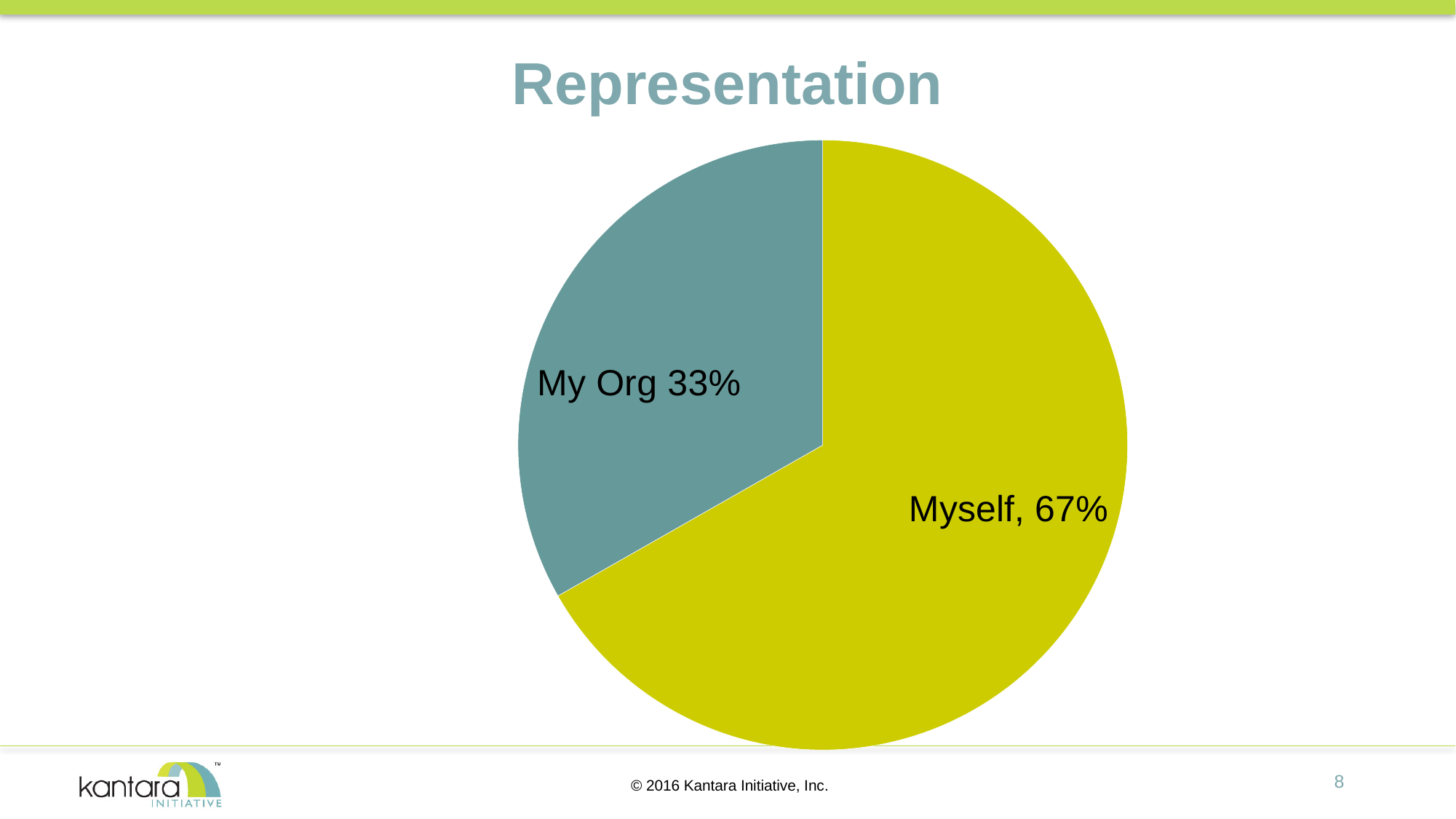
What is the title of the chart? Representation Which is larger, the Myself slice or the My Org slice? Myself What share of the pie does the My Org slice represent? 33% What share of the pie does the Myself slice represent? 67% Which slice is the largest? Myself How many slices does the pie chart have? 2 Which slice is the smallest? My Org What colour is the Myself slice? yellow-green What is the difference in percentage points between the Myself and My Org slices? 34 What kind of chart is shown on the slide? pie chart